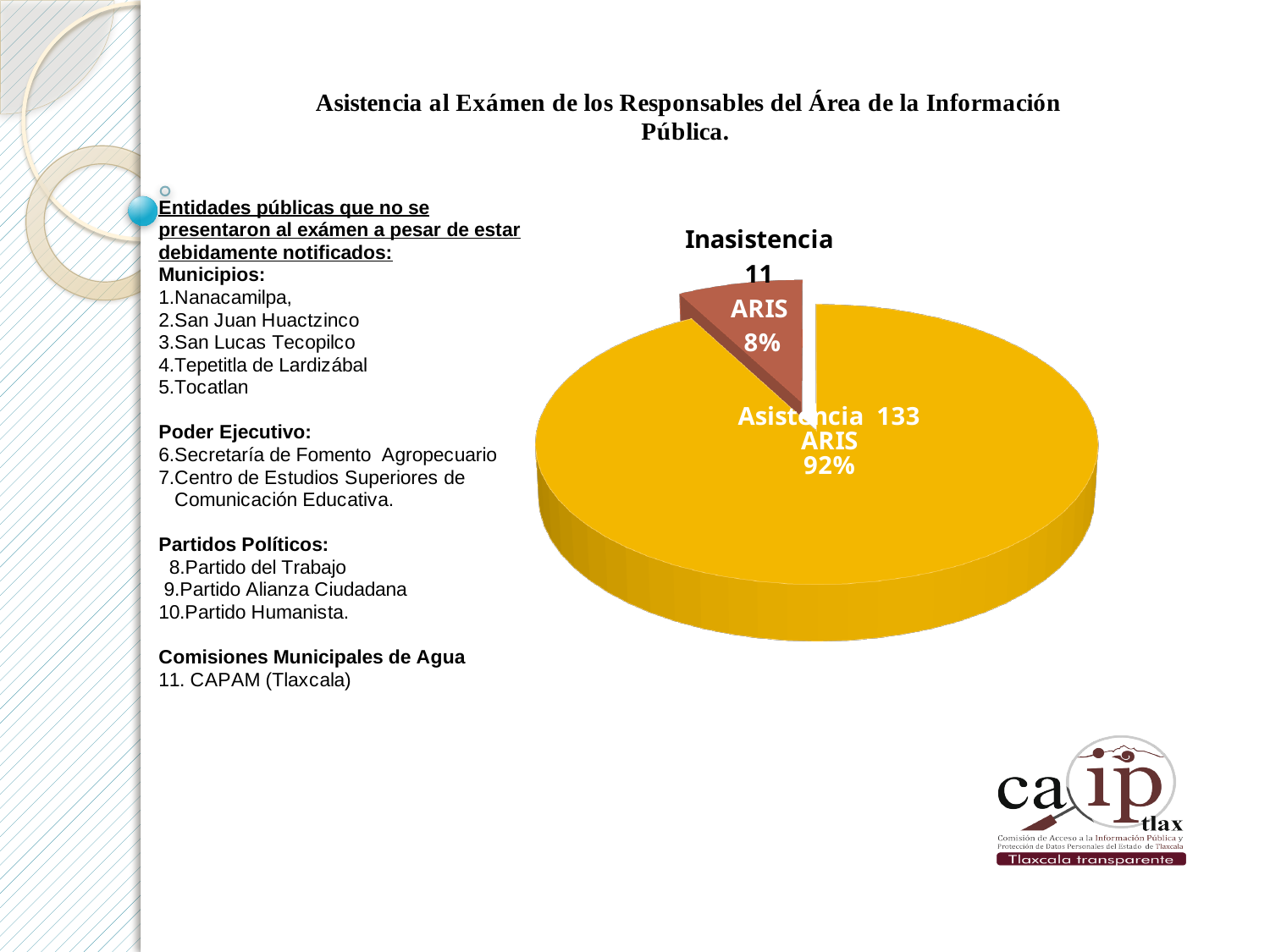
What colour is the Inasistencia slice of the pie chart? brown/red What is the value shown for the Asistencia slice? 133 What percentage of the pie does the Asistencia slice represent? 92% How many slices does the pie chart have? 2 What percentage of the pie does the Inasistencia slice represent? 8% Which is larger, the Asistencia slice or the Inasistencia slice? Asistencia What is the difference between the Asistencia value and the Inasistencia value? 122 Which slice of the pie chart is the smallest? Inasistencia What kind of chart is shown on the slide? pie chart What is the total of the two values shown in the pie chart? 144 What is the value shown for the Inasistencia slice? 11 Which slice of the pie chart is the largest? Asistencia